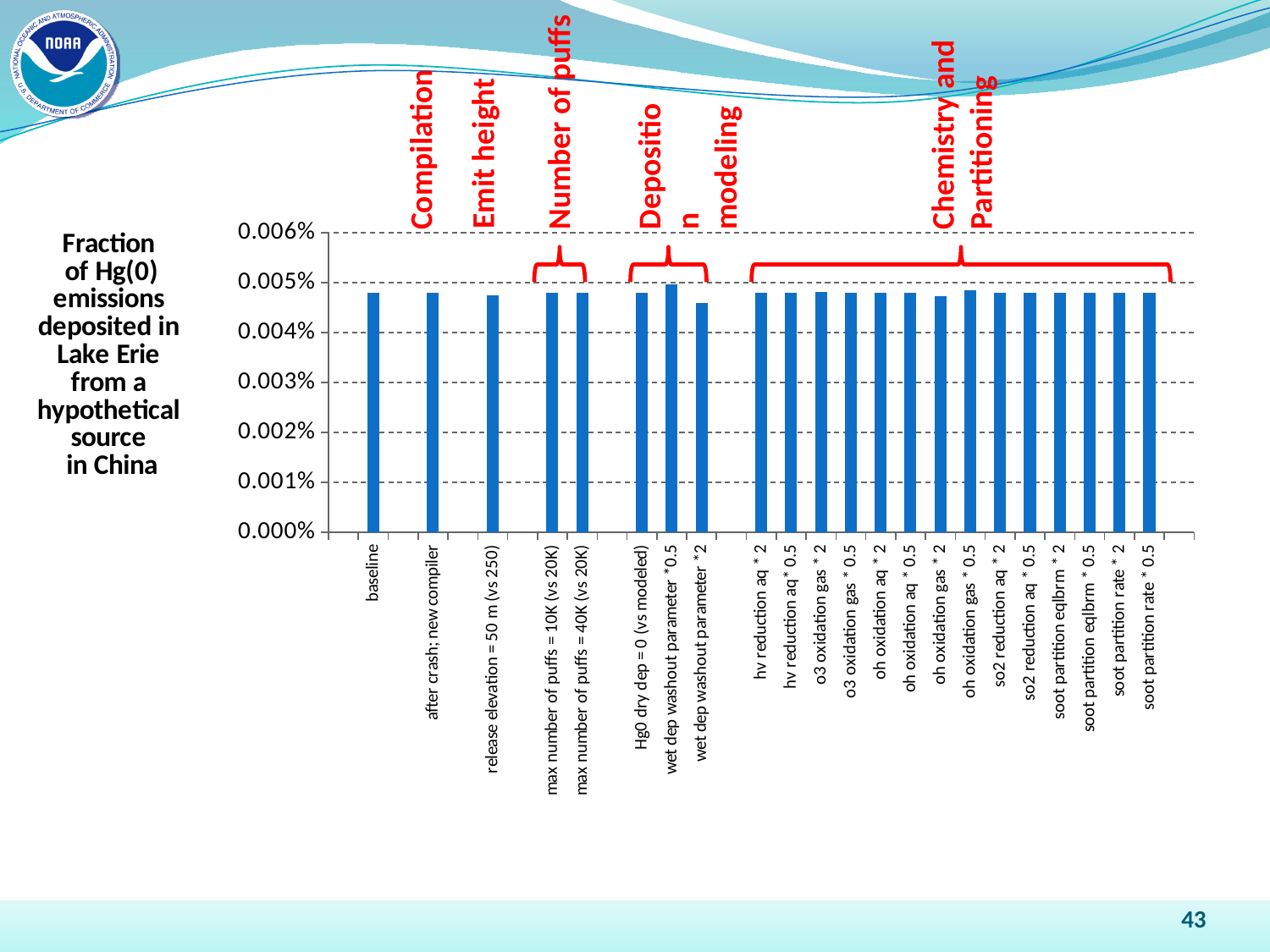
Do the bar values generally rise, fall, or stay roughly flat across the categories from left to right? roughly flat Is the value for 'baseline' greater or less than 0.005%? less Which category has the highest bar on the chart? wet dep washout parameter *0.5 Which category has the lowest bar on the chart? wet dep washout parameter *2 What is the highest value shown on the vertical axis? 0.006% Is the value for 'baseline' greater or less than 0.004%? greater How many categories (bars) are plotted on the chart? 22 Is the value for 'wet dep washout parameter *2' greater or less than 0.005%? less What kind of chart is shown on the slide? bar chart Which is larger, the value for 'wet dep washout parameter *0.5' or 'wet dep washout parameter *2'? wet dep washout parameter *0.5 What quantity does the text to the left of the chart say is plotted? Fraction of Hg(0) emissions deposited in Lake Erie from a hypothetical source in China